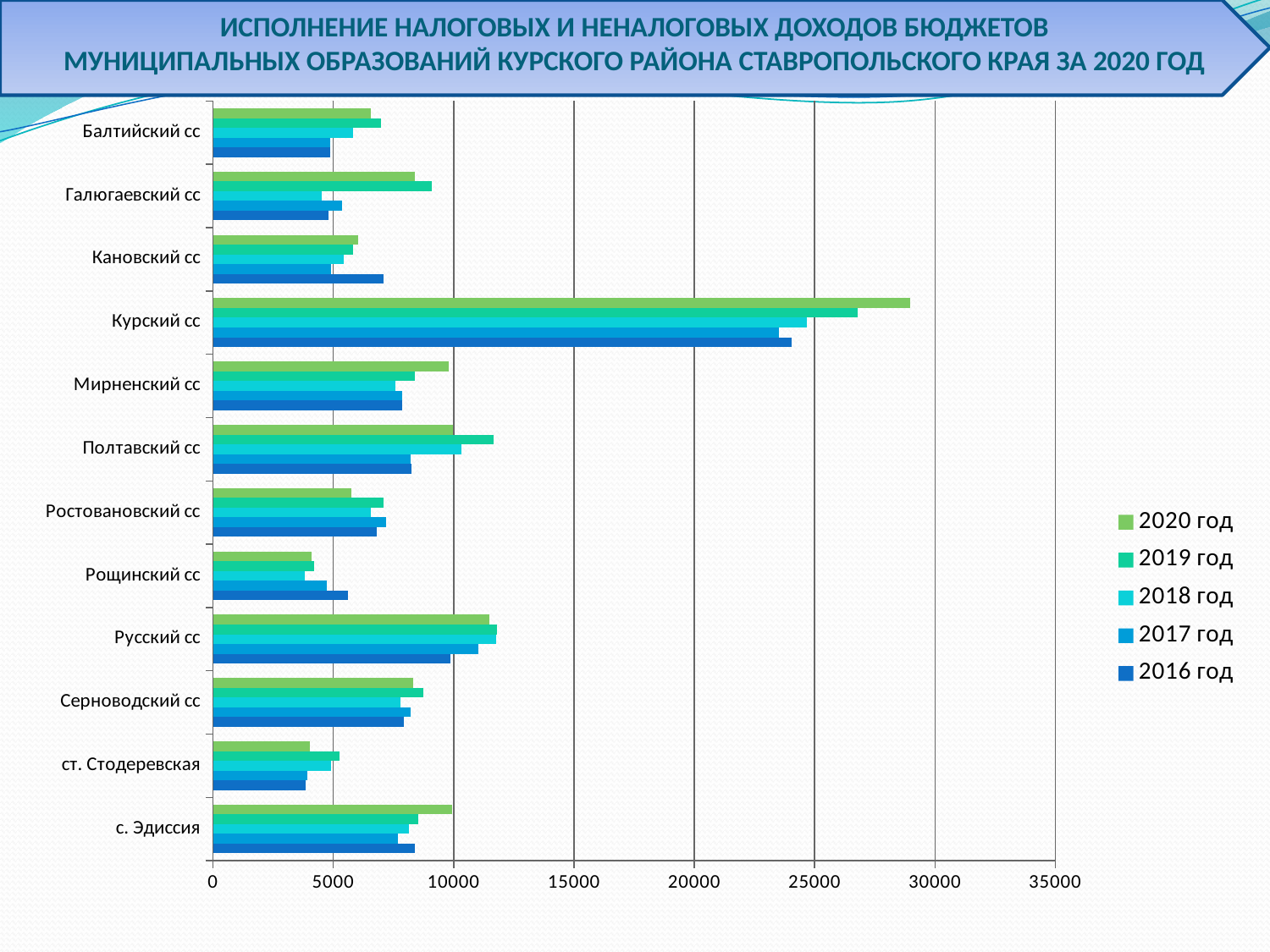
Is the 2020 год value for Курский сс greater or less than 25000? greater For Галюгаевский сс, which is larger: the 2019 год value or the 2016 год value? 2019 год How many municipalities (categories) are listed on the vertical axis of the chart? 12 Is the 2020 год value for Рощинский сс greater or less than 5000? less Is the 2020 год value for Русский сс greater or less than 10000? greater For Рощинский сс, which is larger: the 2016 год value or the 2020 год value? 2016 год How many series does the chart legend list? 5 Which municipality has the highest value for 2020 год? Курский сс What kind of chart is shown on the slide? bar chart Which series is listed first in the chart legend? 2020 год